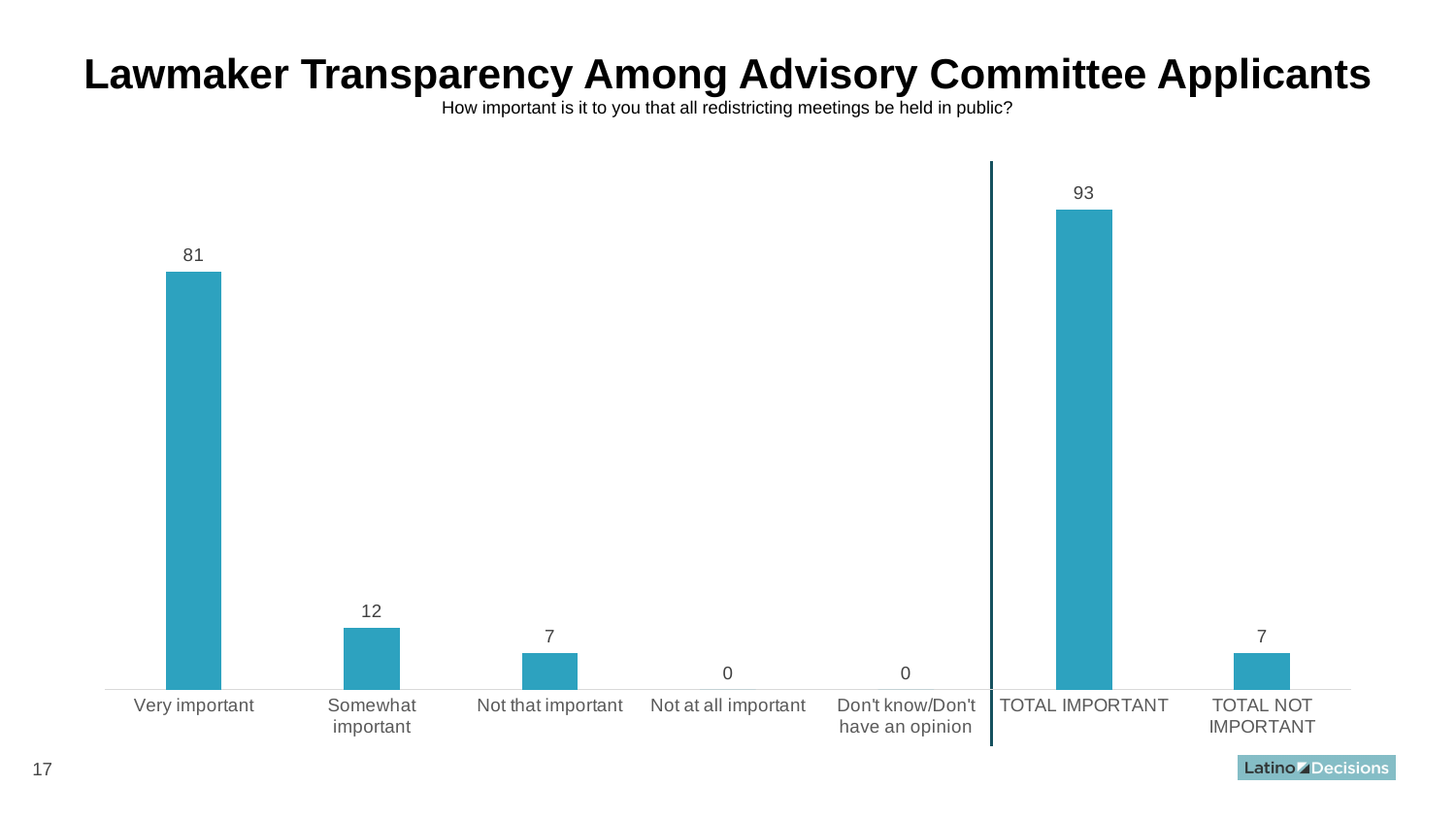
What is the value for "Very important"? 81 What is the title of the chart? Lawmaker Transparency Among Advisory Committee Applicants What is the value for "TOTAL IMPORTANT"? 93 What is the difference between "TOTAL IMPORTANT" and "TOTAL NOT IMPORTANT"? 86 How many categories are shown on the x axis? 7 What is the value for "Don't know/Don't have an opinion"? 0 What survey question is shown as the subtitle of the chart? How important is it to you that all redistricting meetings be held in public? Which is larger, "Somewhat important" or "Not that important"? Somewhat important Which category has the highest value? TOTAL IMPORTANT What kind of chart is shown on the slide? Bar chart What is the value for "Somewhat important"? 12 What is the difference between "Very important" and "Somewhat important"? 69